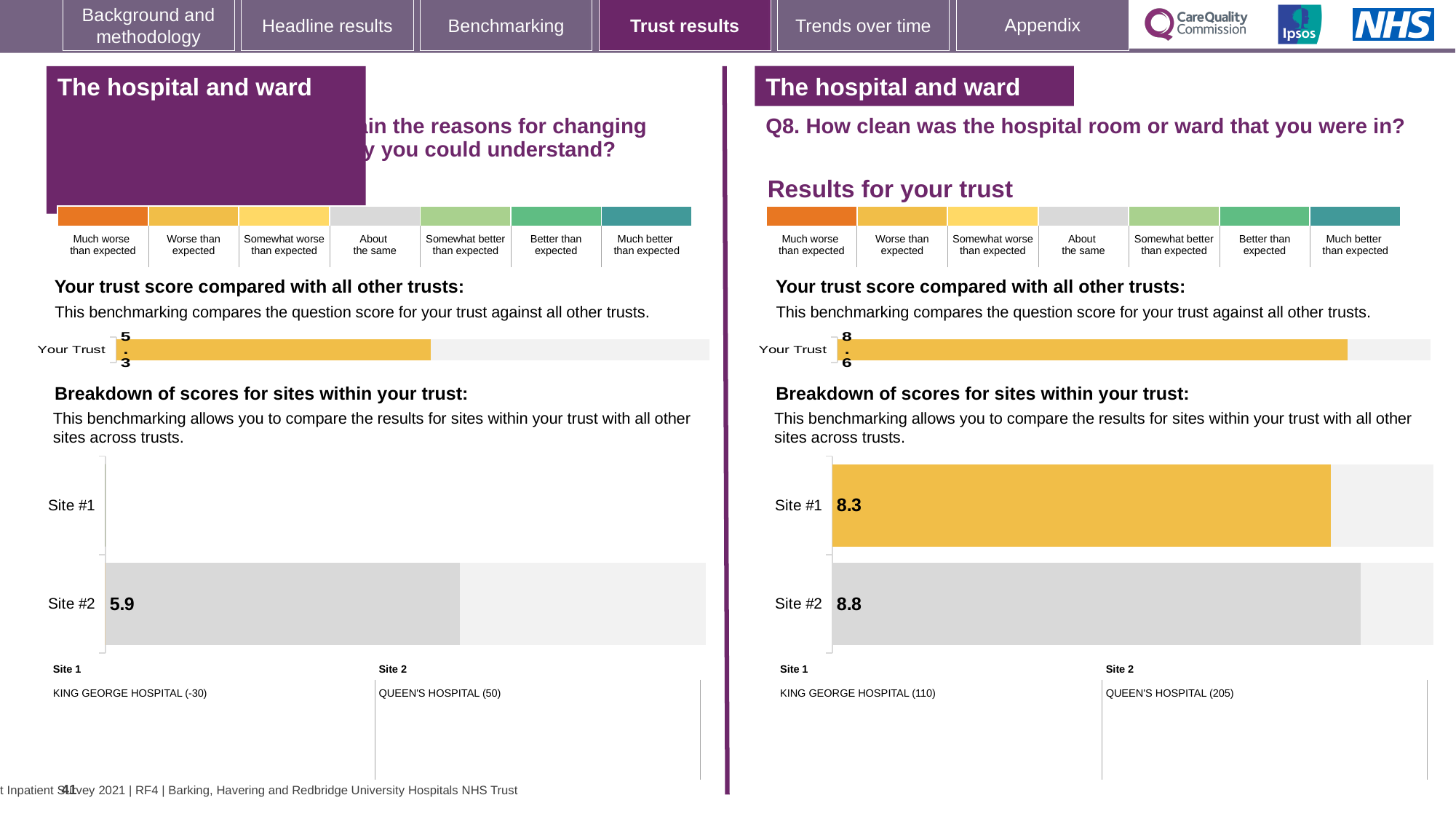
What type of chart is used to show the breakdown of scores for sites on the right-hand panel? Bar chart On the left-hand chart (breakdown of scores for sites), what is the score for Site #2? 5.9 On the right-hand panel (Q8), what is the 'Your Trust' score shown in the trust benchmarking bar? 8.6 On the right-hand chart (Q8, how clean was the hospital room or ward), what is the score for Site #2? 8.8 On the right-hand chart (Q8), what is the difference between the Site #2 score and the Site #1 score? 0.5 On the right-hand chart (Q8, how clean was the hospital room or ward), what is the score for Site #1? 8.3 On the left-hand panel, which hospital is listed as Site 1? KING GEORGE HOSPITAL (-30) On the left-hand panel, what is the 'Your Trust' score shown in the trust benchmarking bar? 5.3 On the right-hand panel (Q8), which hospital is Site 2 and how many respondents are shown in brackets? QUEEN'S HOSPITAL (205) On the right-hand chart (Q8), which site has the higher score, Site #1 or Site #2? Site #2 On the right-hand chart (Q8), which site has the lowest score? Site #1 How many sites are listed in the breakdown chart on the right-hand panel (Q8)? 2